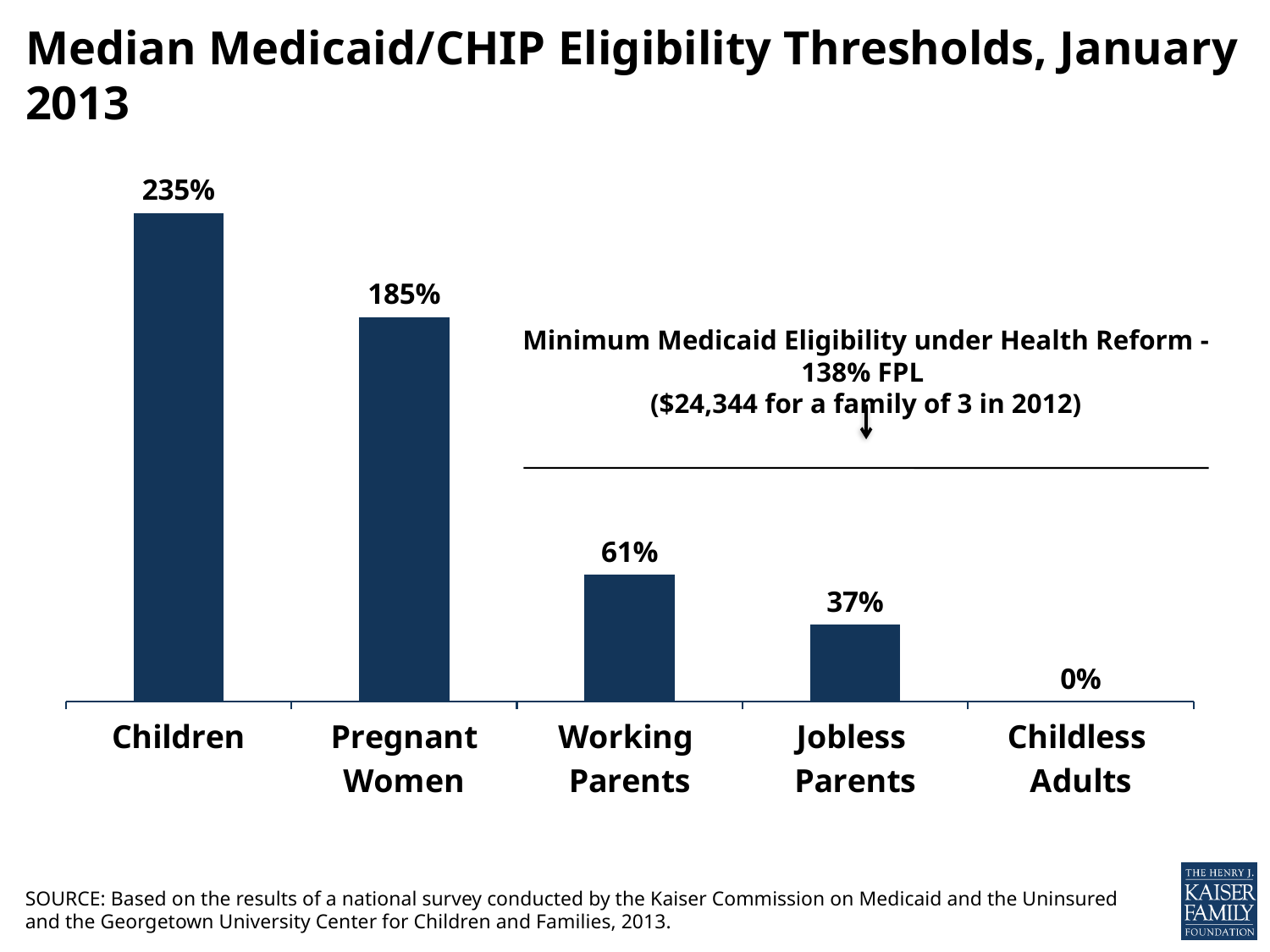
What kind of chart is shown on the slide? Bar chart What is the difference between the thresholds for Children and Pregnant Women? 50 percentage points What is the median eligibility threshold for Childless Adults? 0% What is the median Medicaid/CHIP eligibility threshold for Children? 235% What minimum Medicaid eligibility level under health reform is marked by the horizontal line on the chart? 138% FPL What is the median eligibility threshold for Working Parents? 61% Which is larger, the threshold for Working Parents or for Jobless Parents? Working Parents What is the median eligibility threshold for Jobless Parents? 37% What is the median eligibility threshold for Pregnant Women? 185% Which category has the highest median eligibility threshold? Children Which category has the lowest median eligibility threshold? Childless Adults How many categories are shown on the chart? 5